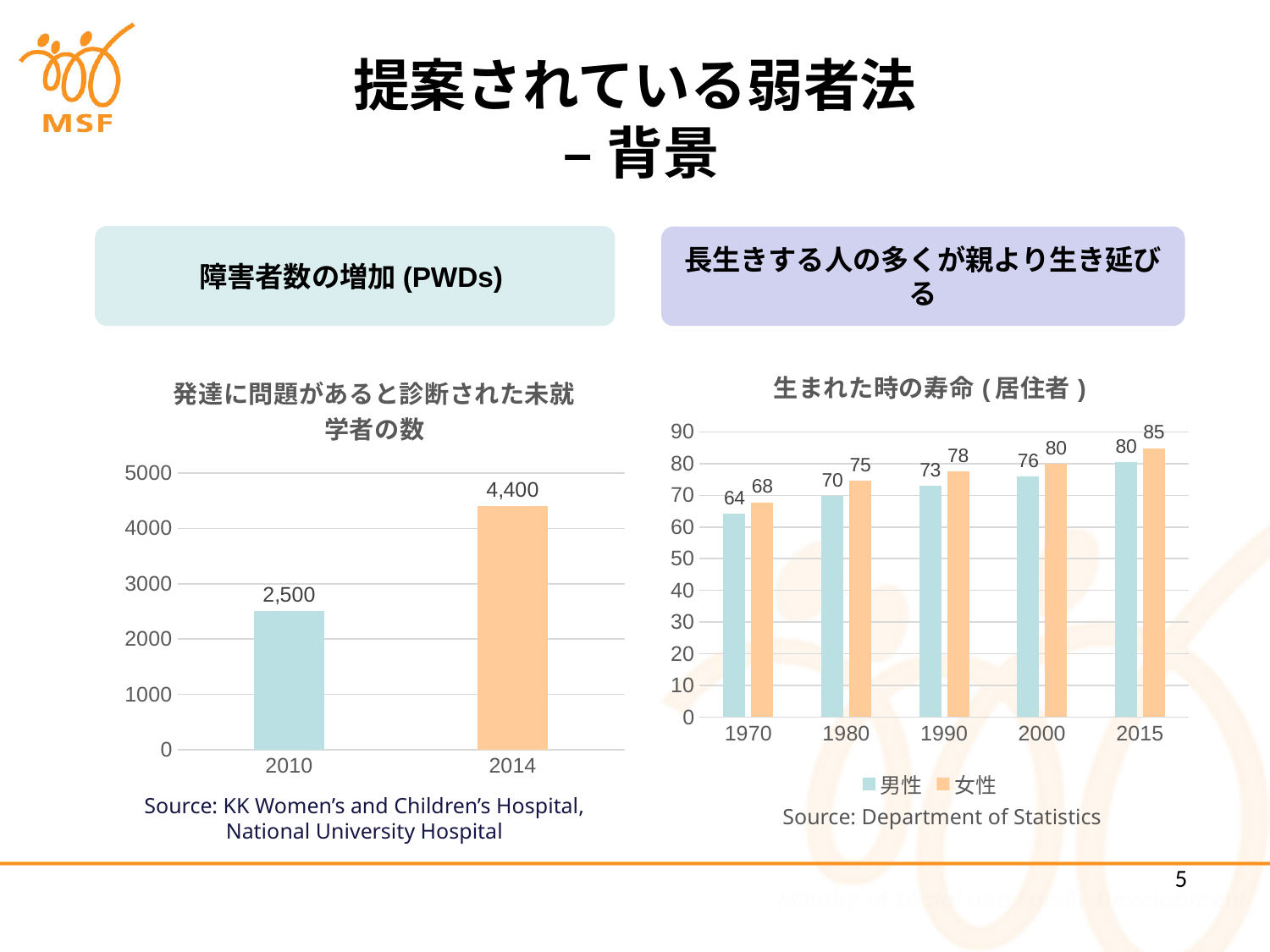
In the left chart (発達に問題があると診断された未就学者の数), what is the value for 2014? 4,400 In the right chart (生まれた時の寿命), which year has the highest value for 男性? 2015 In the right chart (生まれた時の寿命), how many series does the legend list? 2 In the right chart (生まれた時の寿命), do the values for 男性 rise or fall from 1970 to 2015? Rise In the right chart (生まれた時の寿命), what is the value for 女性 in 2015? 85 In the left chart (発達に問題があると診断された未就学者の数), what kind of chart is it? Bar chart In the right chart (生まれた時の寿命), what is the difference between 女性 and 男性 in 1990? 5 In the left chart (発達に問題があると診断された未就学者の数), how many categories are shown on the x axis? 2 In the right chart (生まれた時の寿命), what is the value for 男性 in 1970? 64 In the right chart (生まれた時の寿命), which year has the lowest value for 女性? 1970 In the left chart (発達に問題があると診断された未就学者の数), what is the value for 2010? 2,500 In the left chart (発達に問題があると診断された未就学者の数), what is the difference between the 2014 and 2010 values? 1,900